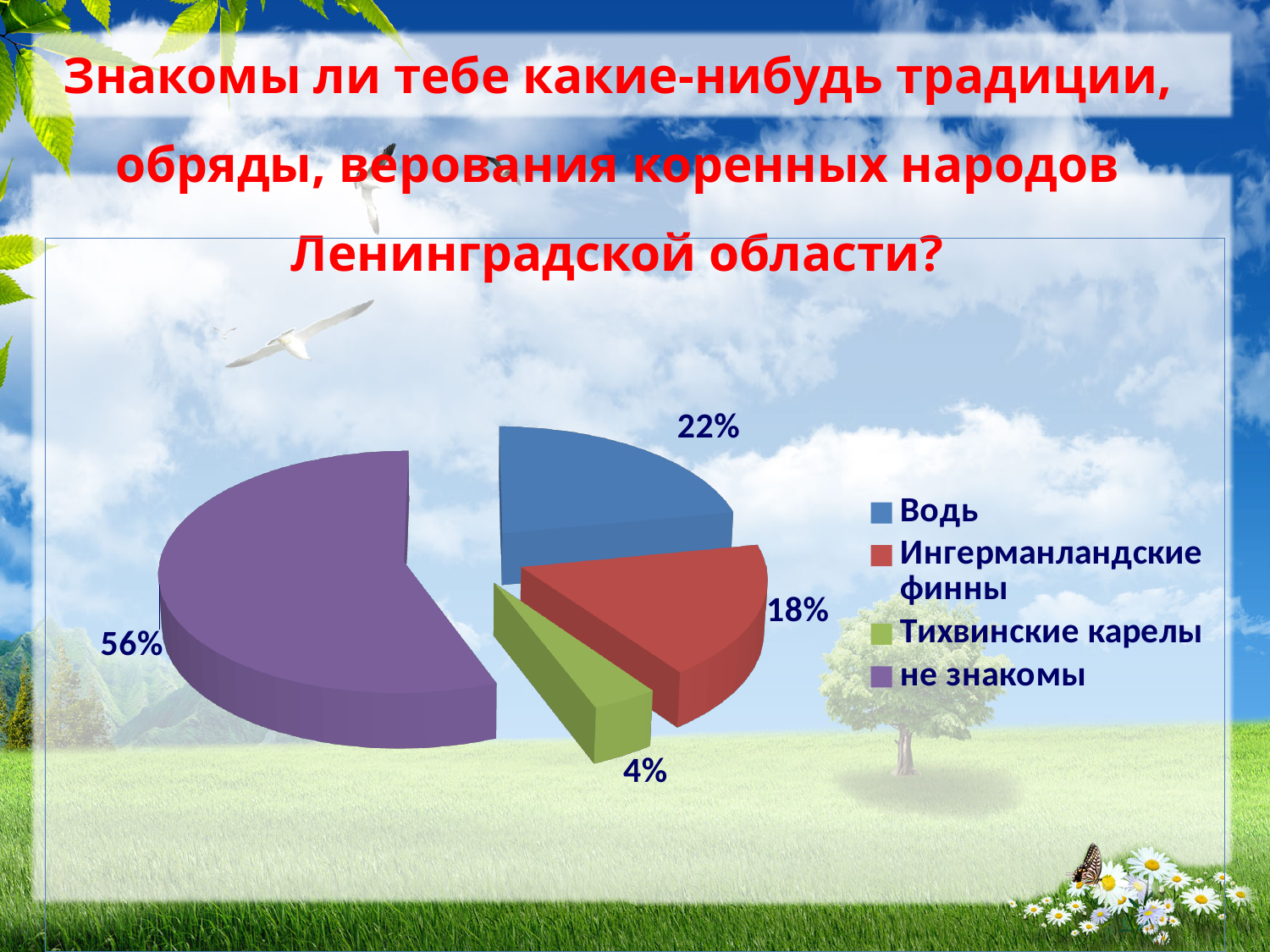
What share of the pie does the slice for Водь represent? 22% What kind of chart is shown on the slide? pie chart What share of the pie does the slice for не знакомы represent? 56% Which slice of the pie is the largest? не знакомы What is the difference between the shares for Водь and Ингерманландские финны? 4% Which slice of the pie is the smallest? Тихвинские карелы Which is larger, the share for Водь or the share for Ингерманландские финны? Водь What share of the pie does the slice for Тихвинские карелы represent? 4% What share of the pie does the slice for Ингерманландские финны represent? 18% How many slices does the pie chart have? 4 What is the difference between the shares for не знакомы and Водь? 34% What colour is the slice for не знакомы? purple